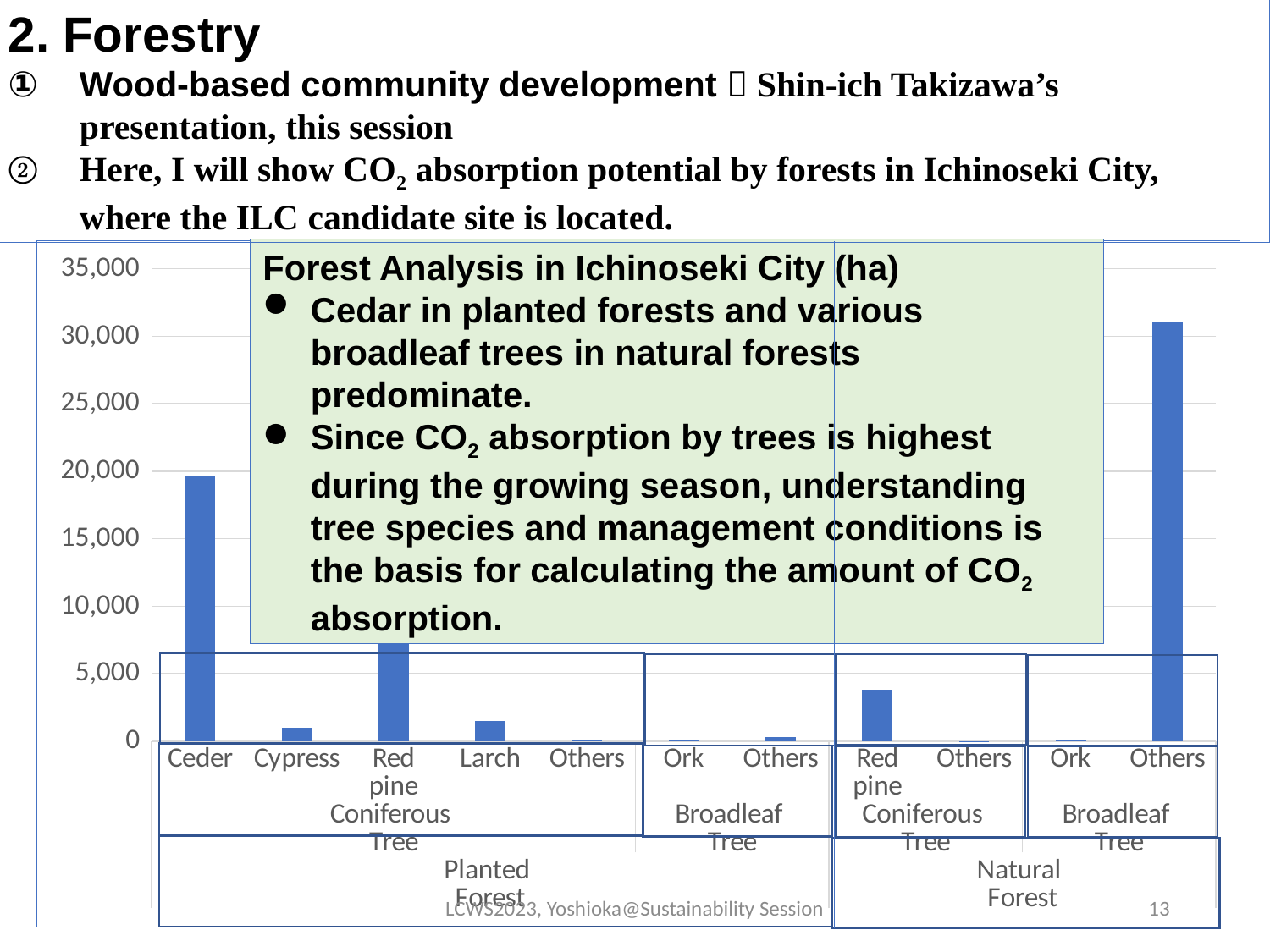
Is the value for Red pine under Coniferous Tree in the Natural Forest greater or less than 5,000? less What kind of chart is shown on the slide? bar chart Is the value for Others under Broadleaf Tree in the Natural Forest greater or less than 30,000? greater Is the value for Ceder in the Planted Forest greater or less than 15,000? greater Which category has the highest bar in the chart? Others (Natural Forest, Broadleaf Tree) Which is larger, the value for Cypress or the value for Larch in the Planted Forest? Larch What is the highest value shown on the vertical axis of the chart? 35,000 What is the title of the chart? Forest Analysis in Ichinoseki City (ha) Which is larger, the value for Ceder in the Planted Forest or the value for Others under Broadleaf Tree in the Natural Forest? Others (Natural Forest, Broadleaf Tree) How many bars (categories) are plotted in the chart? 11